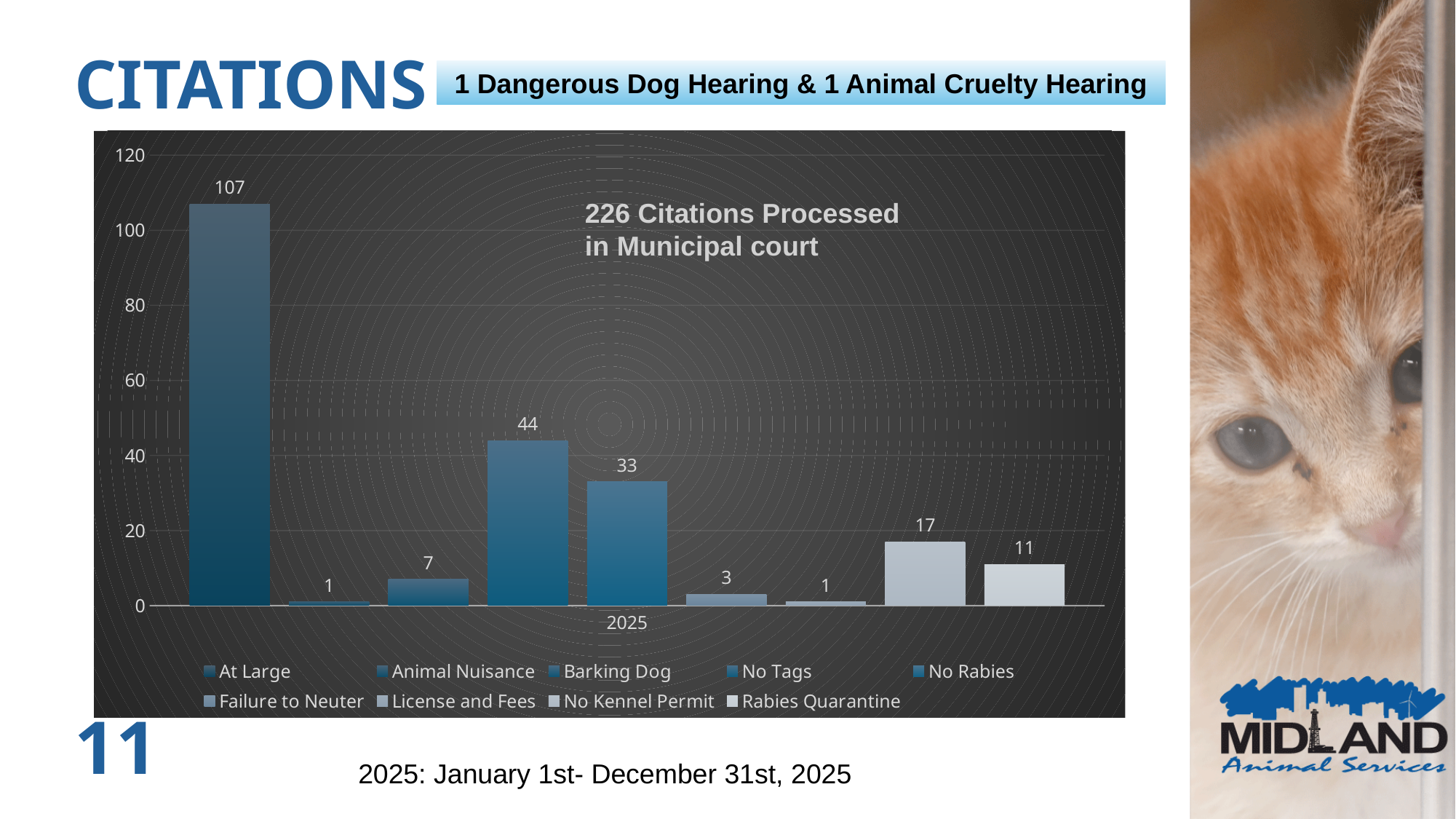
What is the value for Rabies Quarantine? 11 What is the value for No Tags? 44 What is the value for No Rabies? 33 Which series has the highest value? At Large What is the value for No Kennel Permit? 17 What is the value for Barking Dog? 7 Which is larger, No Kennel Permit or Rabies Quarantine? No Kennel Permit What is the value for At Large? 107 What is the difference between the values for No Tags and No Rabies? 11 What kind of chart is shown? Bar chart What category label appears on the x axis? 2025 How many series does the legend list? 9